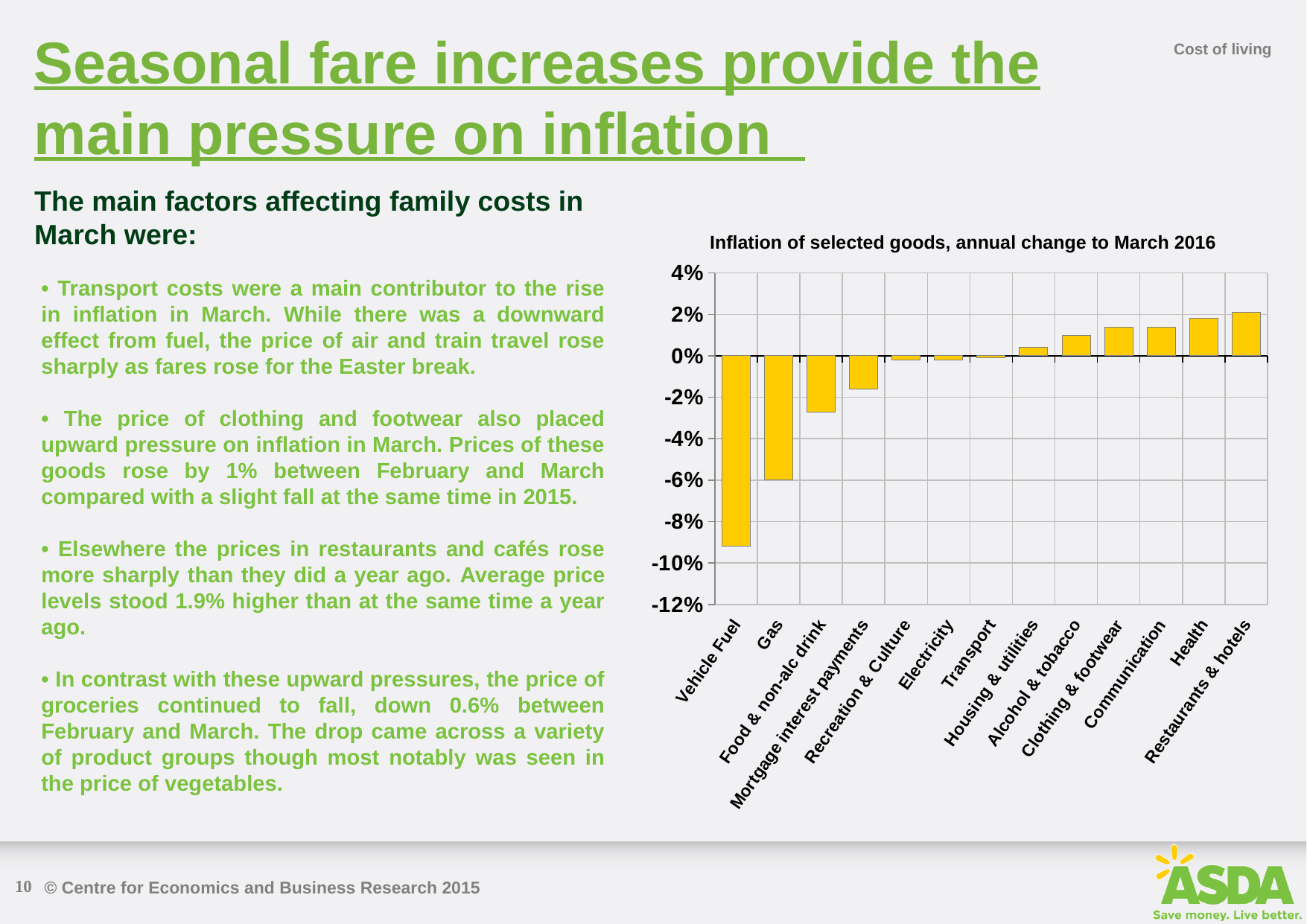
Is the value for Food & non-alc drink greater or less than -2%? less Is the value for Mortgage interest payments greater or less than -2%? greater What is the title of the chart? Inflation of selected goods, annual change to March 2016 Which is larger, the value for Health or the value for Alcohol & tobacco? Health Is the value for Gas greater or less than -4%? less Do the values generally rise or fall moving from left to right along the x axis? Rise Which category has the lowest annual inflation in the chart? Vehicle Fuel What kind of chart is shown on the slide? Bar chart Which category has the highest annual inflation in the chart? Restaurants & hotels How many categories are plotted in the chart? 13